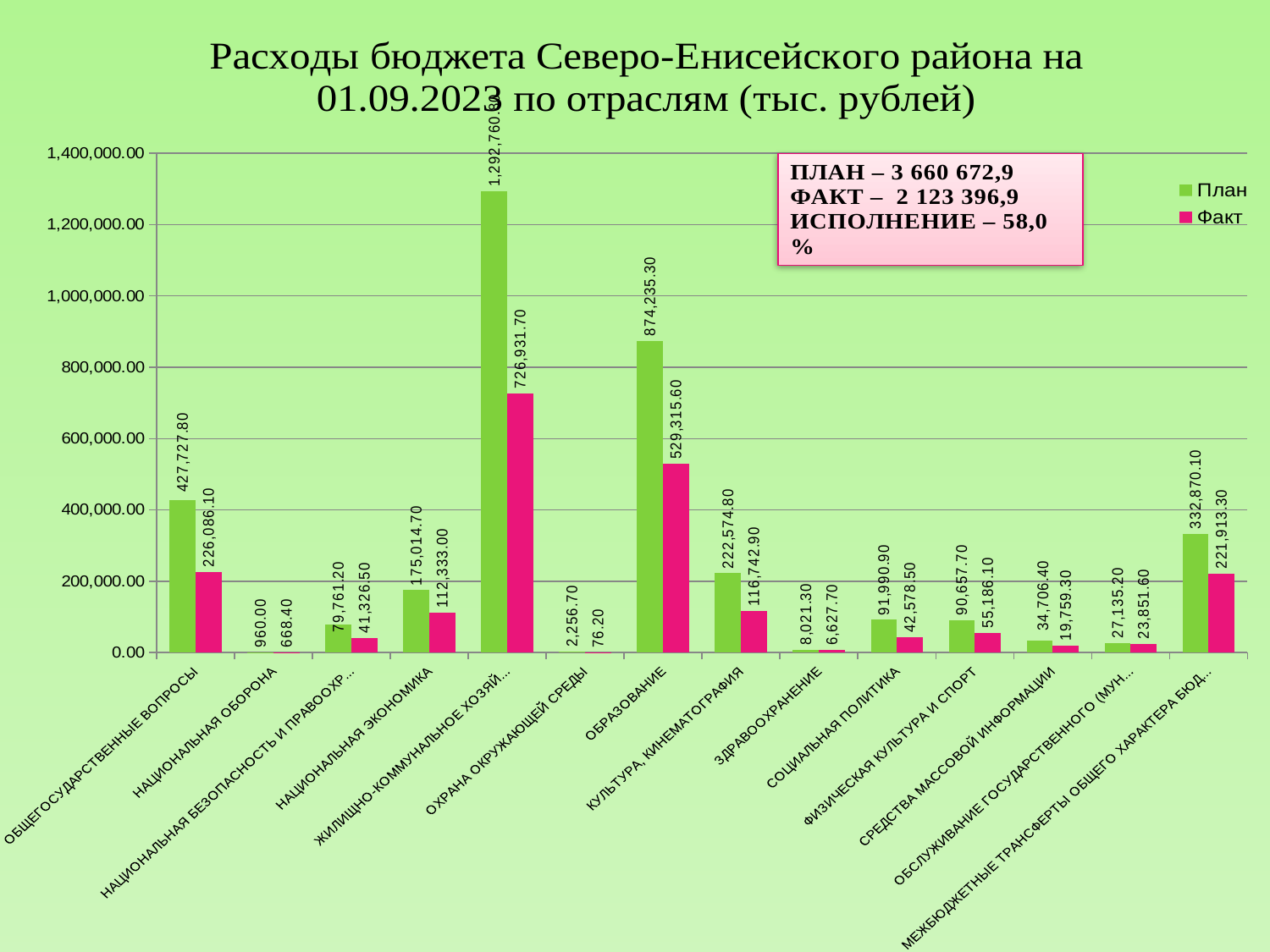
Which category has the lowest Факт value? ОХРАНА ОКРУЖАЮЩЕЙ СРЕДЫ Is the План value for ОБРАЗОВАНИЕ greater or less than 800,000.00? greater How many categories are shown on the x axis? 14 What is the Факт value for НАЦИОНАЛЬНАЯ ОБОРОНА? 668.40 What execution percentage (ИСПОЛНЕНИЕ) is stated in the text box on the chart? 58,0 % What is the Факт value for ЖИЛИЩНО-КОММУНАЛЬНОЕ ХОЗЯЙ...? 726,931.70 What kind of chart is shown on the slide? bar chart Which category has the highest План value? ЖИЛИЩНО-КОММУНАЛЬНОЕ ХОЗЯЙ... What is the difference between the План and Факт values for ОБРАЗОВАНИЕ? 344,919.70 Which has the larger Факт value: СОЦИАЛЬНАЯ ПОЛИТИКА or ФИЗИЧЕСКАЯ КУЛЬТУРА И СПОРТ? ФИЗИЧЕСКАЯ КУЛЬТУРА И СПОРТ How many series does the legend list? 2 What is the План value for ОБРАЗОВАНИЕ? 874,235.30